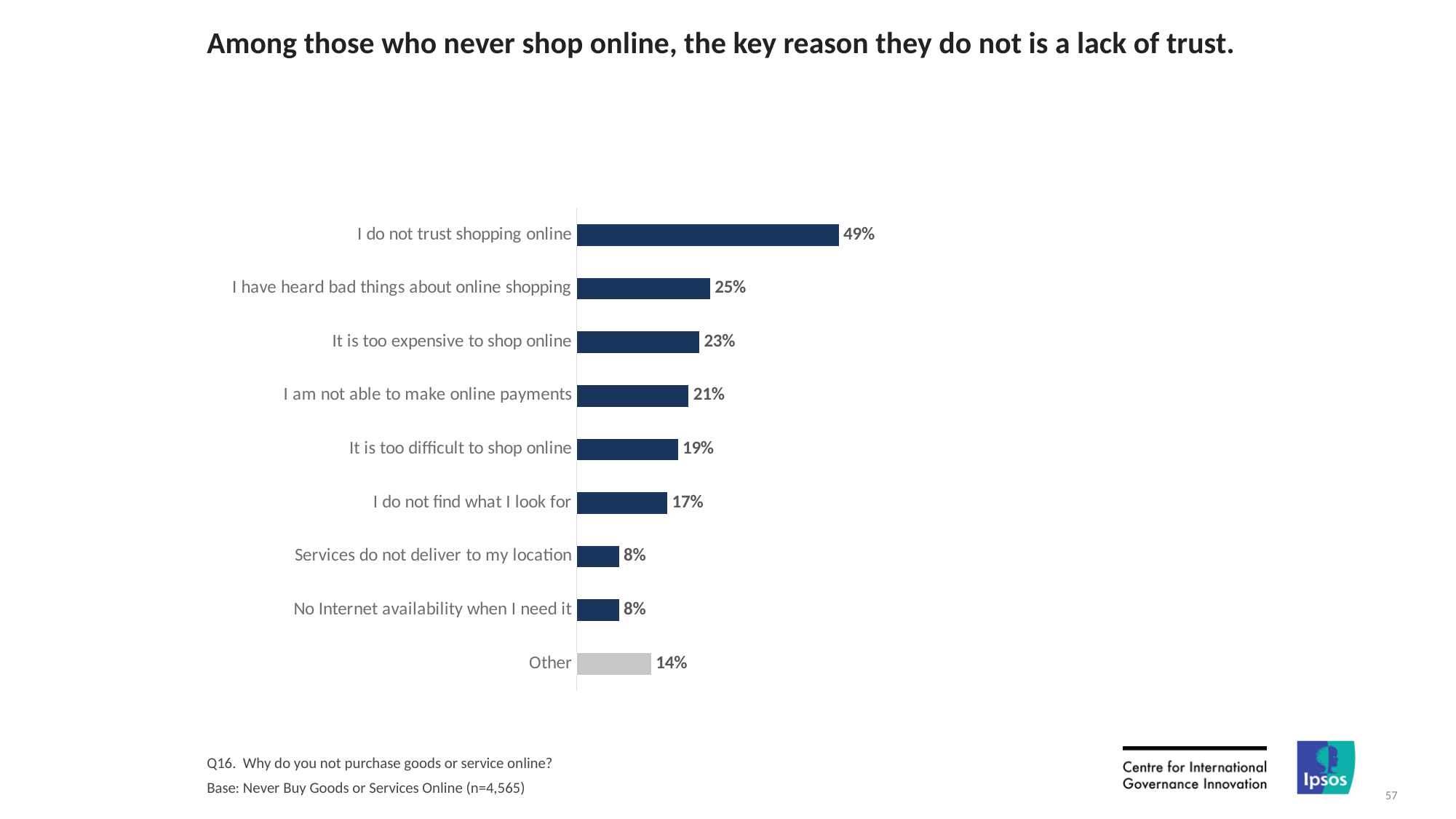
What is the difference between "It is too difficult to shop online" and "I do not find what I look for"? 2 percentage points What is the value for "It is too expensive to shop online"? 23% What kind of chart is shown on the slide? Bar chart Which is larger: "It is too expensive to shop online" or "I am not able to make online payments"? It is too expensive to shop online What is the difference between "I do not trust shopping online" and "I have heard bad things about online shopping"? 24 percentage points Which bar is shown in a different colour (grey) from the others? Other Which two reasons share the same value of 8%? Services do not deliver to my location; No Internet availability when I need it What is the value for "I am not able to make online payments"? 21% Which reason has the highest percentage? I do not trust shopping online What percentage of respondents said "I do not trust shopping online"? 49% What percentage is shown for "Other"? 14% How many reasons (categories) are shown in the chart? 9